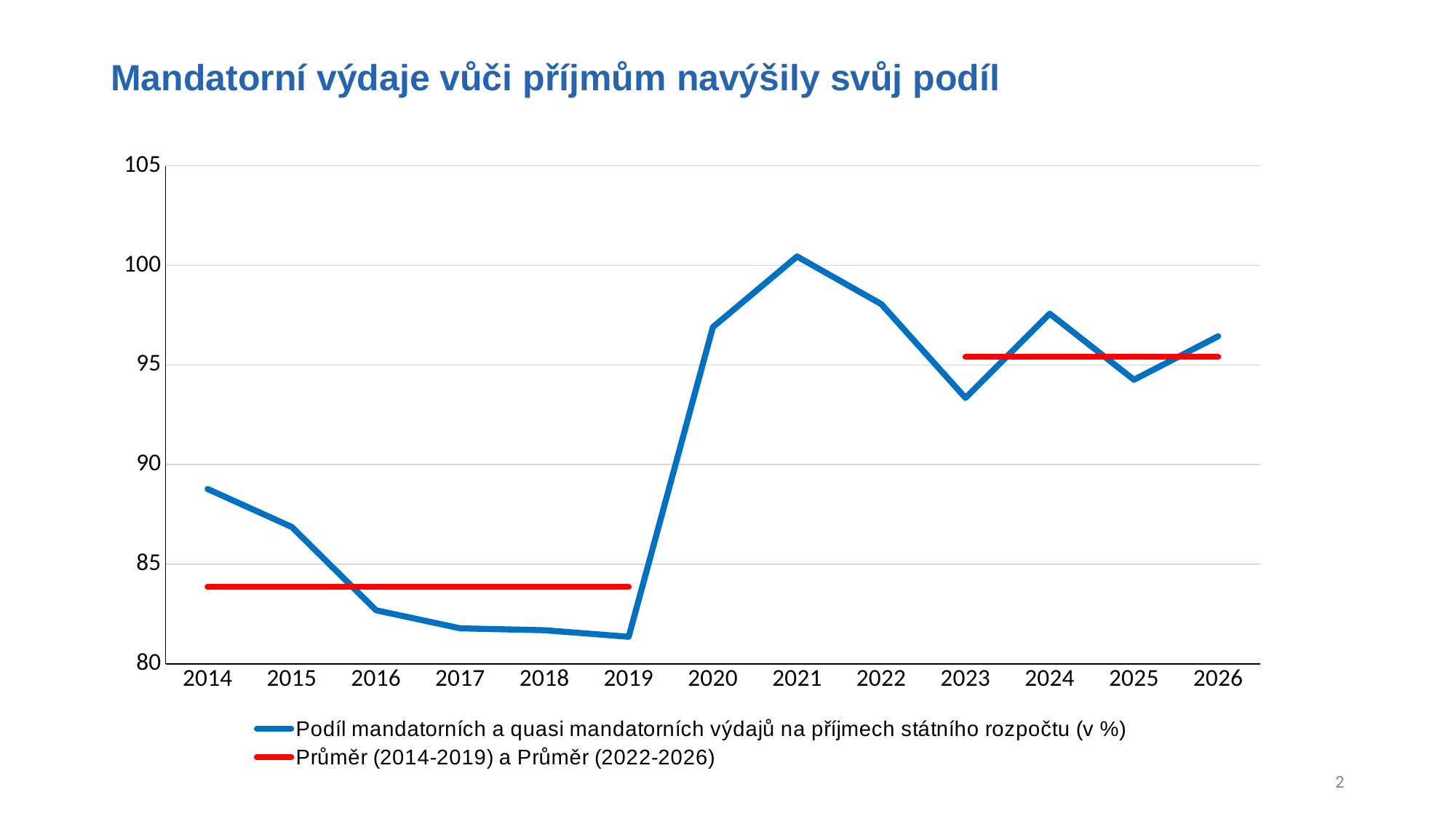
In which year does the blue line (Podíl mandatorních a quasi mandatorních výdajů) reach its highest value? 2021 Is the value of the blue line for 2023 greater or less than 95? less Which year has the larger value on the blue line, 2024 or 2025? 2024 Does the blue line rise or fall between 2014 and 2019? fall How many series does the chart legend list? 2 What kind of chart is shown on the slide? line chart Is the value of the blue line for 2014 greater or less than 90? less Is the value of the blue line for 2020 greater or less than 95? greater How many years are shown on the x axis of the chart? 13 What colour are the lines showing the averages (Průměr) in the chart? red Which year has the larger value on the blue line, 2014 or 2019? 2014